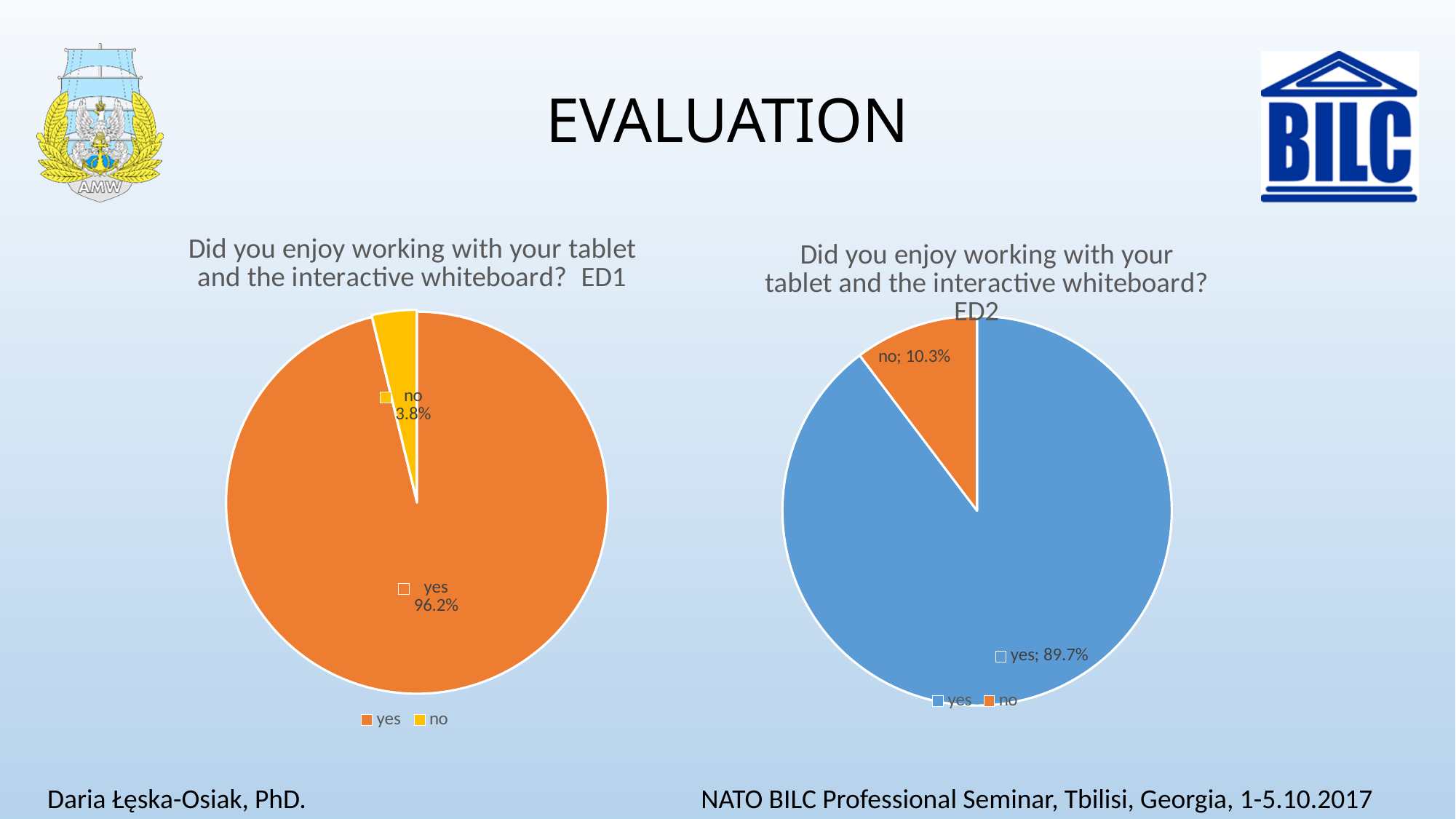
In the ED2 pie chart on the right, what share of respondents answered "yes"? 89.7% Which chart has the larger "no" share, the ED1 chart on the left or the ED2 chart on the right? ED2 In the ED1 pie chart on the left, what share of respondents answered "yes"? 96.2% In the ED2 pie chart on the right, what share of respondents answered "no"? 10.3% In the ED2 pie chart on the right, which answer has the smallest slice? no In the ED2 pie chart on the right, what colour is the "yes" slice? blue In the ED1 pie chart on the left, what share of respondents answered "no"? 3.8% How many entries does the legend of the ED1 pie chart on the left list? 2 In the ED1 pie chart on the left, which answer has the largest slice? yes What kind of chart is used for the ED1 results on the left? pie chart What is the difference between the "yes" share in the ED1 chart and the "yes" share in the ED2 chart? 6.5% How many slices does the ED2 pie chart on the right have? 2